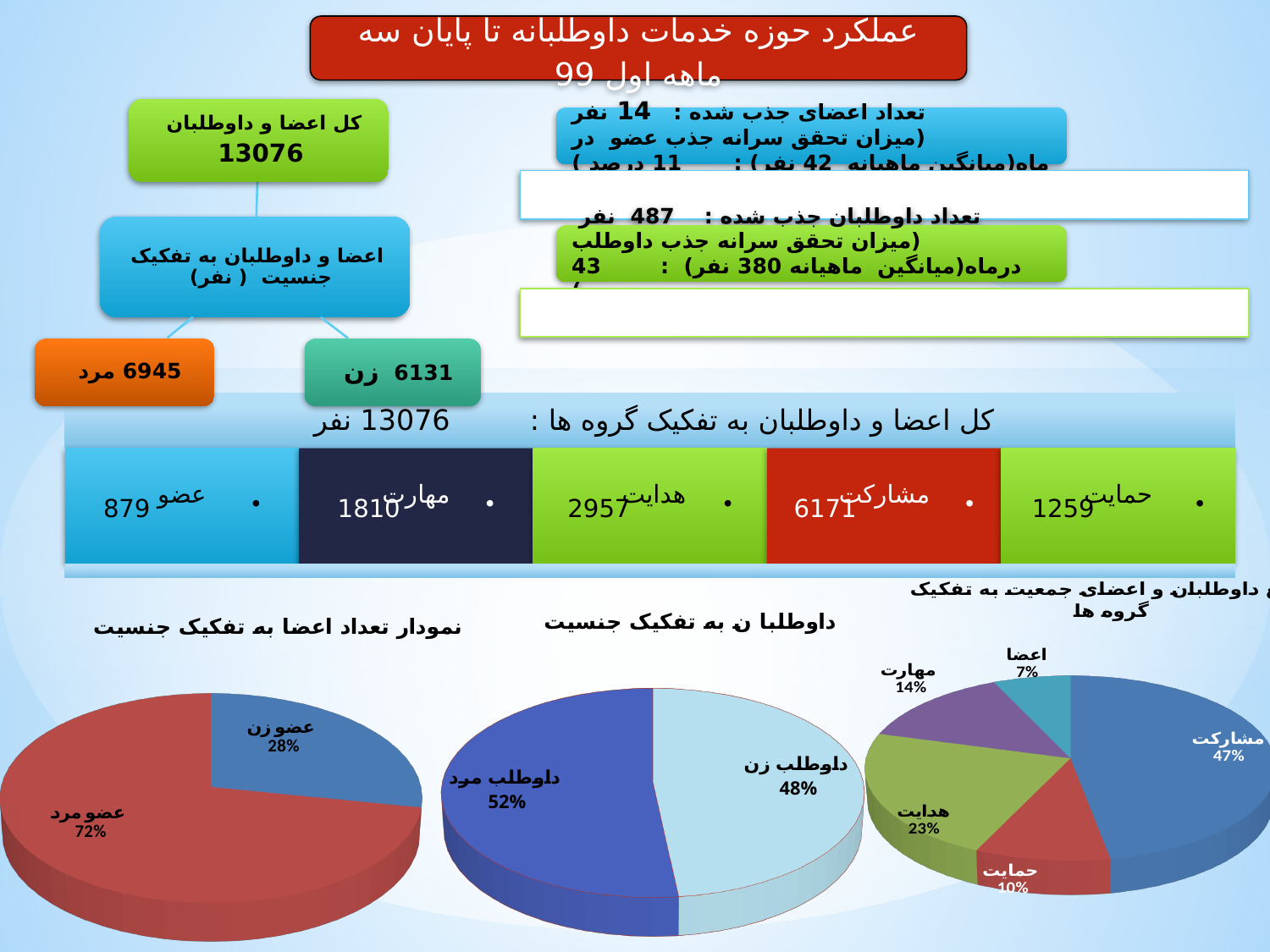
In the right pie chart (داوطلبان و اعضای جمعیت به تفکیک گروه ها), which group has the smallest share? اعضا In the right pie chart (داوطلبان و اعضای جمعیت به تفکیک گروه ها), which group has the largest share? مشارکت In the left pie chart (نمودار تعداد اعضا به تفکیک جنسیت), what share is shown for عضو زن? 28% What type of chart is used for the three charts at the bottom of the slide? Pie chart In the left pie chart (نمودار تعداد اعضا به تفکیک جنسیت), what is the difference in percentage points between عضو مرد and عضو زن? 44 In the right pie chart (داوطلبان و اعضای جمعیت به تفکیک گروه ها), what share is shown for مشارکت? 47% How many slices does the right pie chart (داوطلبان و اعضای جمعیت به تفکیک گروه ها) have? 5 In the left pie chart (نمودار تعداد اعضا به تفکیک جنسیت), what share is shown for عضو مرد? 72% In the left pie chart (نمودار تعداد اعضا به تفکیک جنسیت), which slice is larger, عضو مرد or عضو زن? عضو مرد In the middle pie chart (داوطلبان به تفکیک جنسیت), what share is shown for داوطلب مرد? 52% In the middle pie chart (داوطلبان به تفکیک جنسیت), what share is shown for داوطلب زن? 48% How many slices does the middle pie chart (داوطلبان به تفکیک جنسیت) have? 2